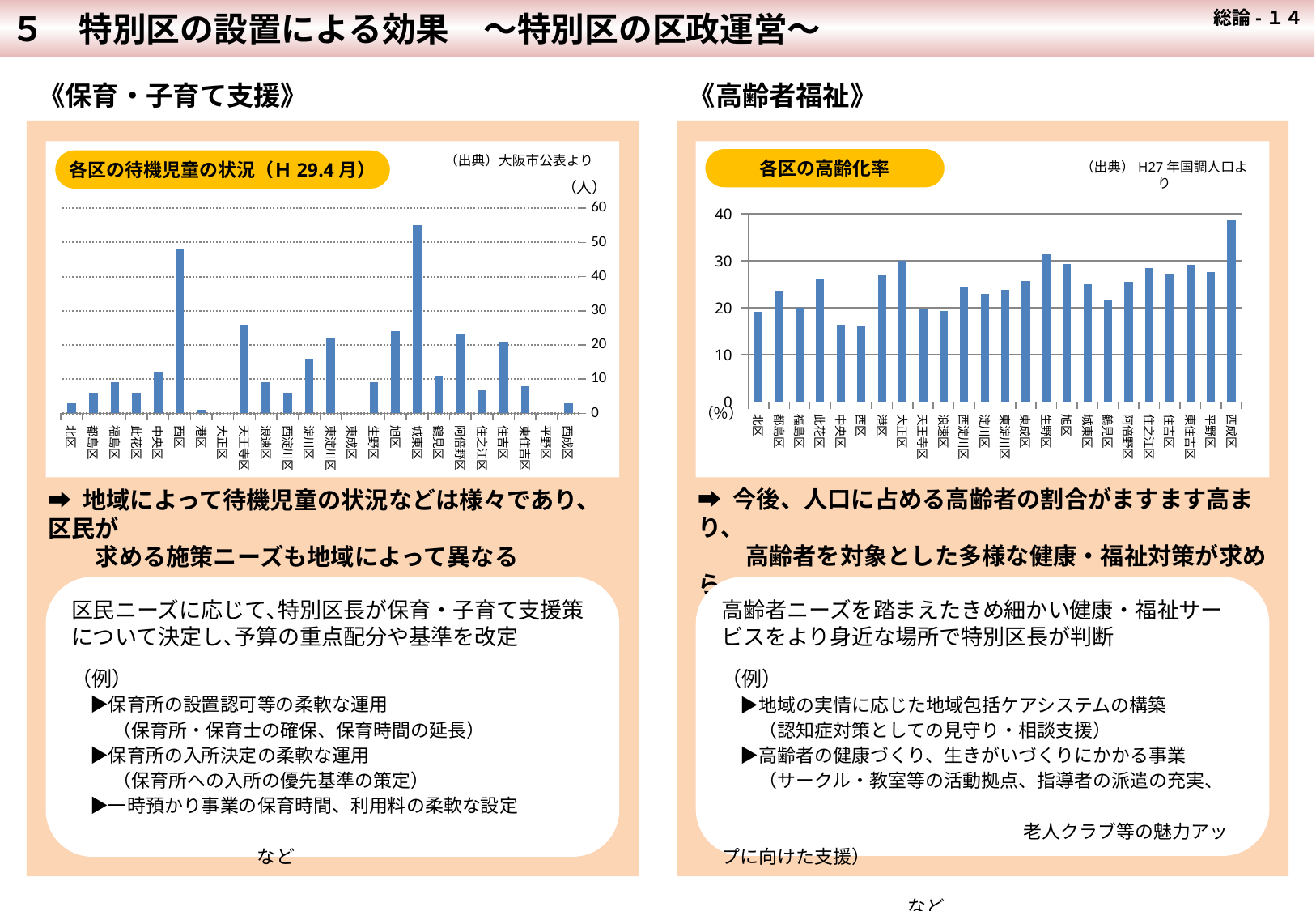
What unit is shown on the y axis of the left chart 各区の待機児童の状況（H29.4月）? 人 In the left chart 各区の待機児童の状況（H29.4月）, which ward has the highest number of waiting children? 城東区 What kind of chart is the left chart titled 各区の待機児童の状況（H29.4月）? bar chart How many wards are shown on the x axis of the left chart 各区の待機児童の状況（H29.4月）? 24 In the right chart 各区の高齢化率, is the value for 西成区 greater or less than 30? greater In the left chart 各区の待機児童の状況（H29.4月）, which is larger, the value for 天王寺区 or the value for 淀川区? 天王寺区 In the left chart 各区の待機児童の状況（H29.4月）, is the value for 北区 greater or less than 10? less In the right chart 各区の高齢化率, is the value for 中央区 greater or less than 20? less In the right chart 各区の高齢化率, which is larger, the value for 生野区 or the value for 北区? 生野区 What is the source noted for the right chart 各区の高齢化率? H27年国調人口より In the right chart 各区の高齢化率, which ward has the highest aging rate? 西成区